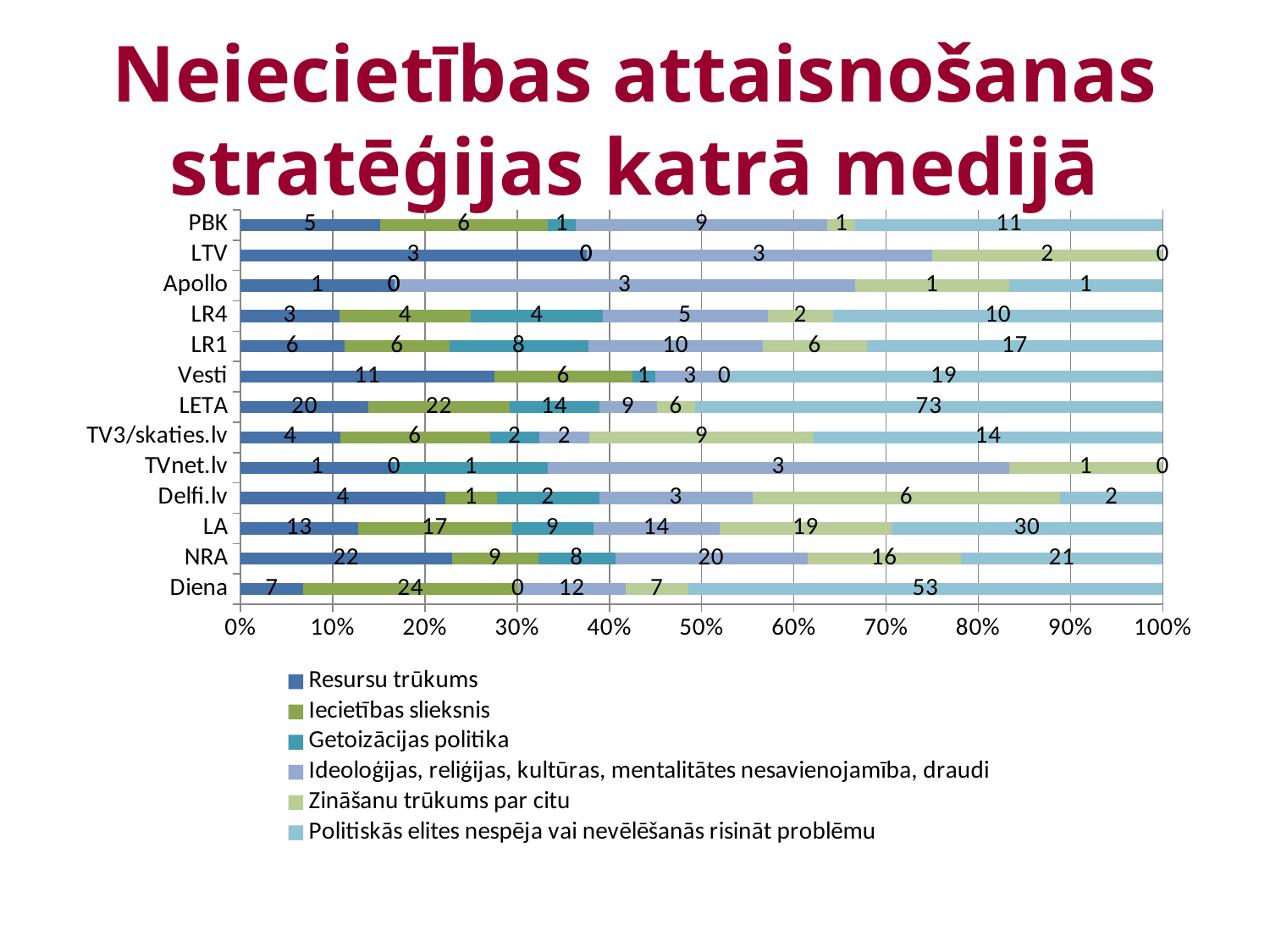
What is the total of all labelled values in the LA bar? 102 Which media outlet has the highest value for 'Politiskās elites nespēja vai nevēlēšanās risināt problēmu'? LETA How many media outlets (categories) are listed on the vertical axis? 13 What is the value of 'Politiskās elites nespēja vai nevēlēšanās risināt problēmu' for LETA? 73 What is the total of all labelled values in the LR1 bar? 53 What is the value of 'Zināšanu trūkums par citu' for LA? 19 What is the value of 'Resursu trūkums' for NRA? 22 Which is larger: the 'Resursu trūkums' value for LETA or for LA? LETA What is the difference between the 'Politiskās elites nespēja vai nevēlēšanās risināt problēmu' values for Diena and LA? 23 How many series does the legend list? 6 What kind of chart is shown on the slide? Stacked bar chart What is the value of 'Iecietības slieksnis' for Diena? 24